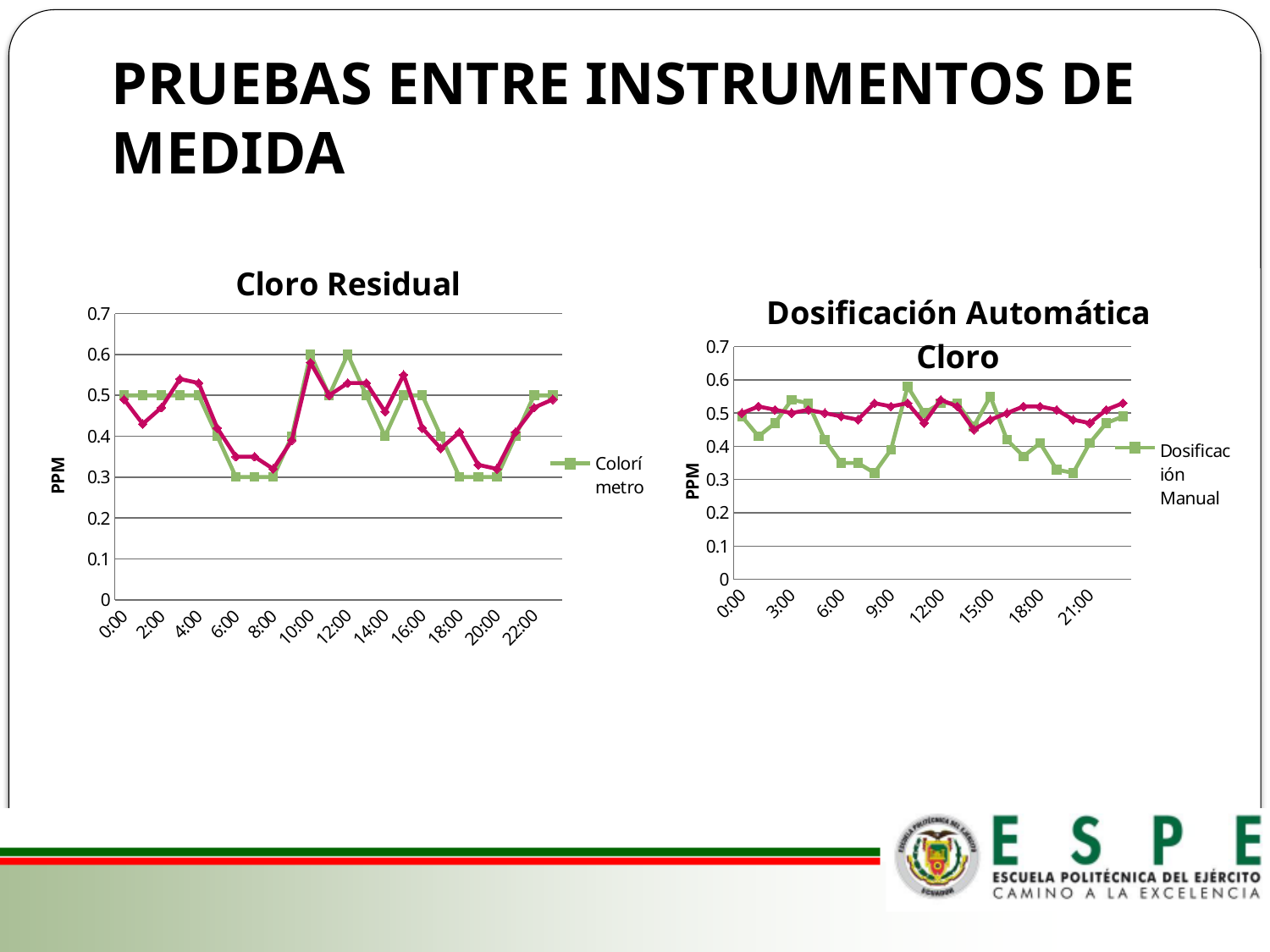
In the 'Cloro Residual' chart, does the Colorímetro line rise or fall between 4:00 and 6:00? fall In the 'Dosificación Automática Cloro' chart, what series name does the legend show? Dosificación Manual In the 'Dosificación Automática Cloro' chart, which is larger for Dosificación Manual: the value at 10:00 or the value at 18:00? 10:00 In the 'Cloro Residual' chart, what is the Colorímetro value at 6:00? 0.3 In the 'Dosificación Automática Cloro' chart, is the Dosificación Manual value at 10:00 greater or less than 0.5? greater What kind of chart is the 'Cloro Residual' chart on the left? line chart In the 'Cloro Residual' chart, which is larger for Colorímetro: the value at 10:00 or the value at 6:00? 10:00 In the 'Cloro Residual' chart, is the Colorímetro value at 10:00 greater or less than 0.5? greater What kind of chart is the 'Dosificación Automática Cloro' chart on the right? line chart In the 'Cloro Residual' chart, is the Colorímetro value at 6:00 greater or less than 0.4? less In the 'Cloro Residual' chart, what is the label on the vertical axis? PPM